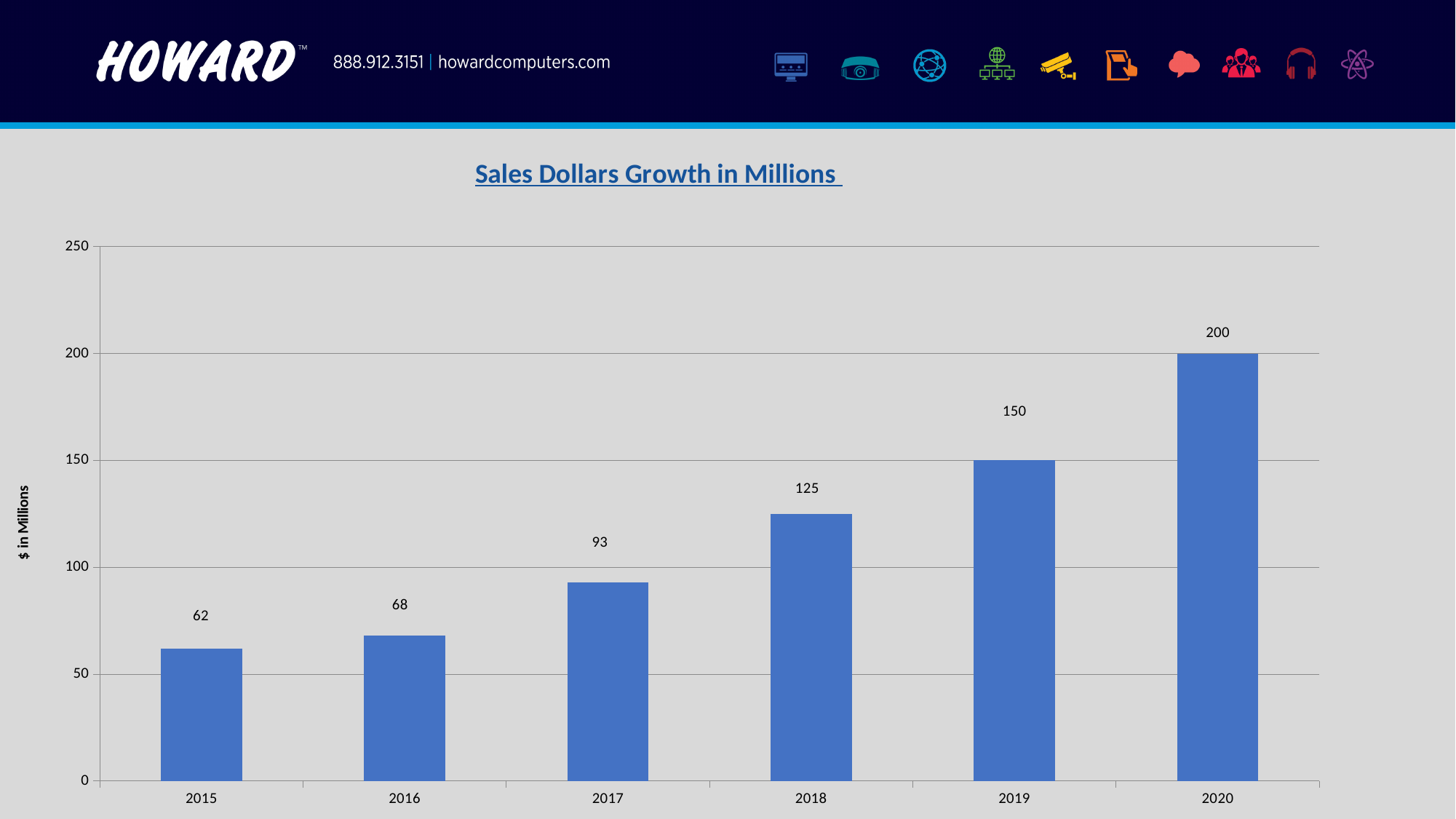
Which is larger, the value for 2018 or the value for 2017? 2018 How many years are shown on the x axis? 6 What is the difference between the values for 2020 and 2019? 50 Which year has the highest value? 2020 What is the difference between the values for 2017 and 2016? 25 Which year has the lowest value? 2015 What is the value for 2015? 62 Do the values rise or fall from 2015 to 2020? rise What is the value for 2018? 125 What kind of chart is shown? bar chart Is the value for 2019 greater or less than 100? greater What is the value for 2020? 200